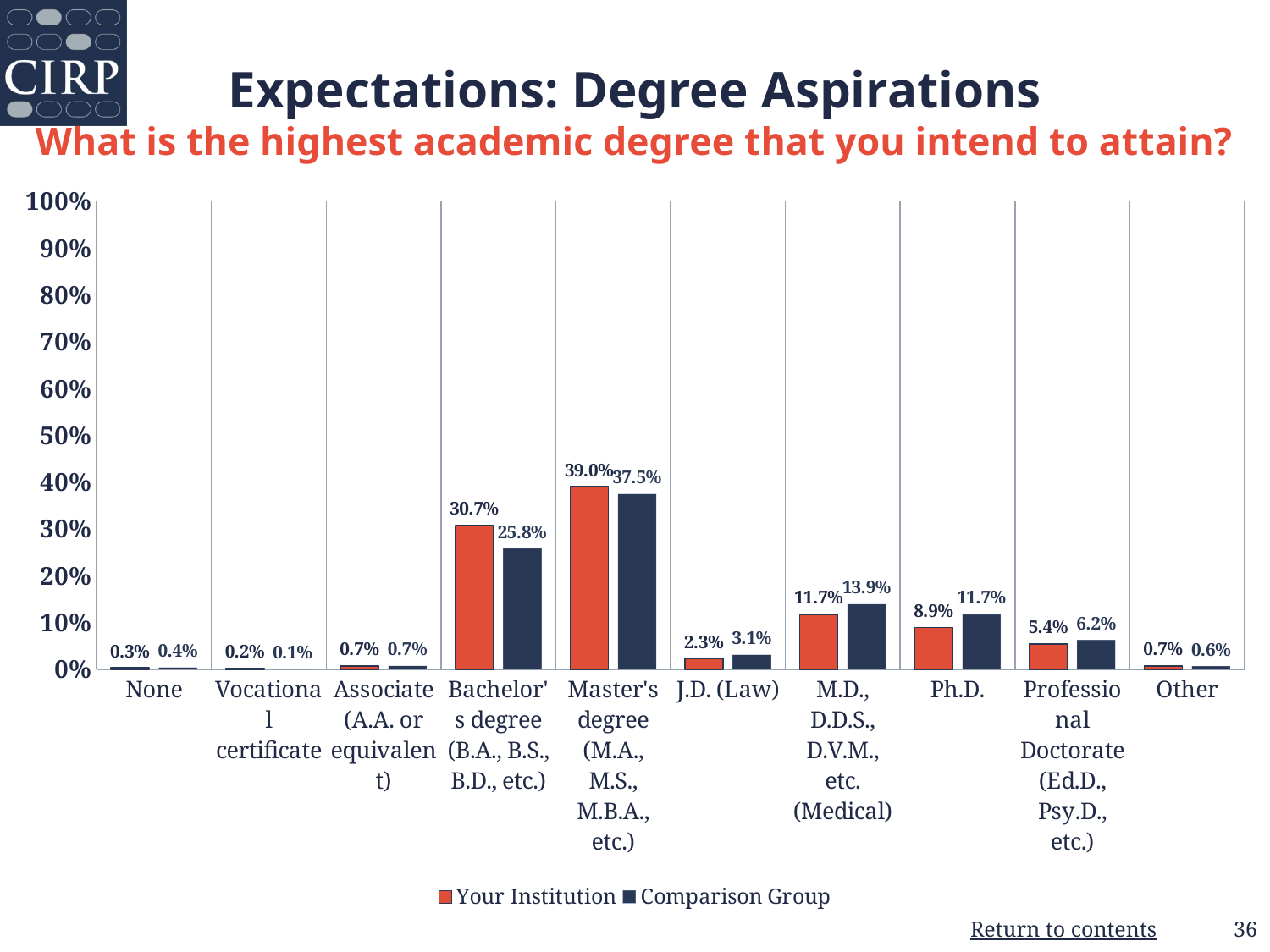
What is the difference between Comparison Group and Your Institution for M.D., D.D.S., D.V.M., etc. (Medical)? 2.2% What is the value for Your Institution for Ph.D.? 8.9% What is the difference between Your Institution and Comparison Group for Bachelor's degree? 4.9% What kind of chart is shown on the slide? bar chart How many series does the legend list? 2 What is the value for Comparison Group for Bachelor's degree? 25.8% What is the value for Your Institution for Master's degree? 39.0% Which is larger for J.D. (Law): Your Institution or Comparison Group? Comparison Group Is the value for Your Institution for Master's degree greater or less than 30%? greater How many categories are shown on the x axis? 10 Which category has the lowest value for Comparison Group? Vocational certificate Which category has the highest value for Your Institution? Master's degree